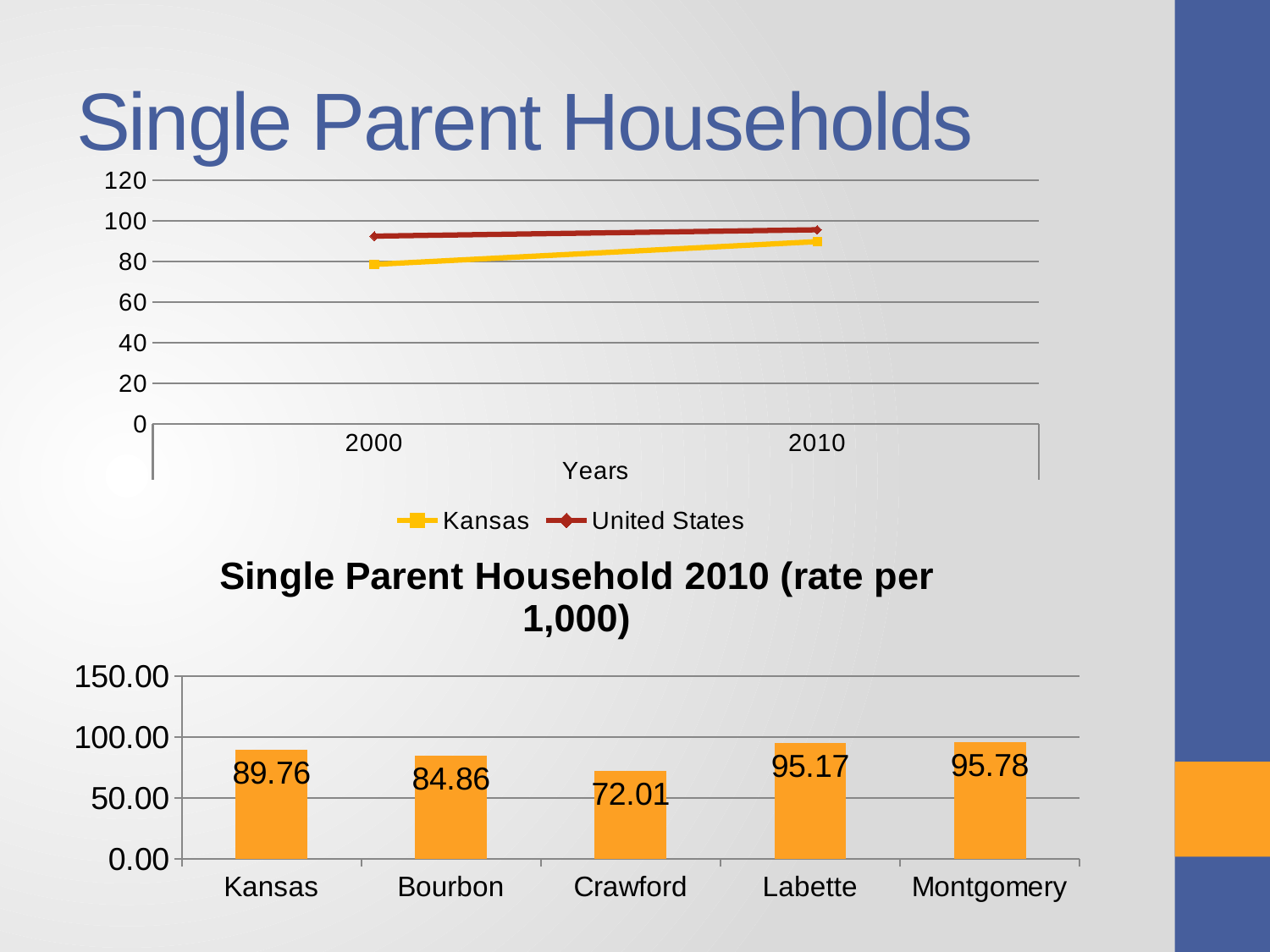
In the 'Single Parent Household 2010 (rate per 1,000)' chart, which category has the highest value? Montgomery In the 'Single Parent Household 2010 (rate per 1,000)' chart, what is the value for Kansas? 89.76 In the top line chart, does the Kansas line rise or fall from 2000 to 2010? rise In the top line chart, is the value for United States in 2010 greater or less than 100? less In the top line chart, which series has the higher value in 2000, Kansas or United States? United States In the top line chart, is the value for Kansas in 2010 greater or less than 80? greater In the 'Single Parent Household 2010 (rate per 1,000)' chart, what is the value for Crawford? 72.01 In the top line chart, what are the two series named in the legend? Kansas and United States In the 'Single Parent Household 2010 (rate per 1,000)' chart, what is the difference between the values for Kansas and Bourbon? 4.90 In the 'Single Parent Household 2010 (rate per 1,000)' chart, which category has the lowest value? Crawford In the top line chart, how many series does the legend list? 2 In the 'Single Parent Household 2010 (rate per 1,000)' chart, how many categories are shown? 5